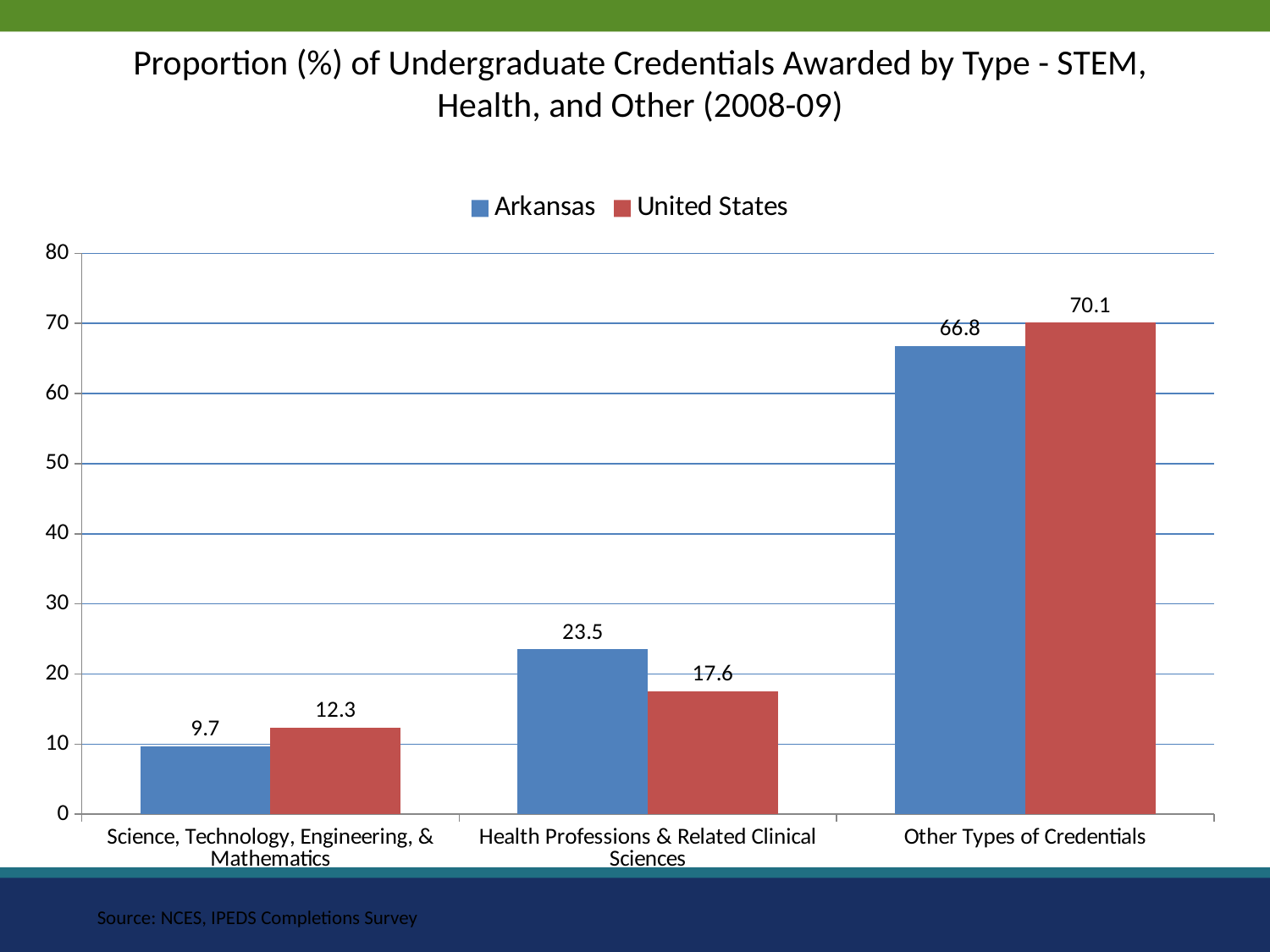
What kind of chart is shown on the slide? bar chart How many categories are shown on the x axis? 3 What is the difference between the United States and Arkansas values for Other Types of Credentials? 3.3 How many series does the legend list? 2 What is the Arkansas value for Other Types of Credentials? 66.8 What is the United States value for Health Professions & Related Clinical Sciences? 17.6 What is the difference between the Arkansas and United States values for Health Professions & Related Clinical Sciences? 5.9 What is the Arkansas value for Science, Technology, Engineering, & Mathematics? 9.7 Which category has the highest United States value? Other Types of Credentials For Health Professions & Related Clinical Sciences, which is larger: Arkansas or United States? Arkansas Is the United States value for Science, Technology, Engineering, & Mathematics greater or less than 10? greater Which category has the lowest Arkansas value? Science, Technology, Engineering, & Mathematics